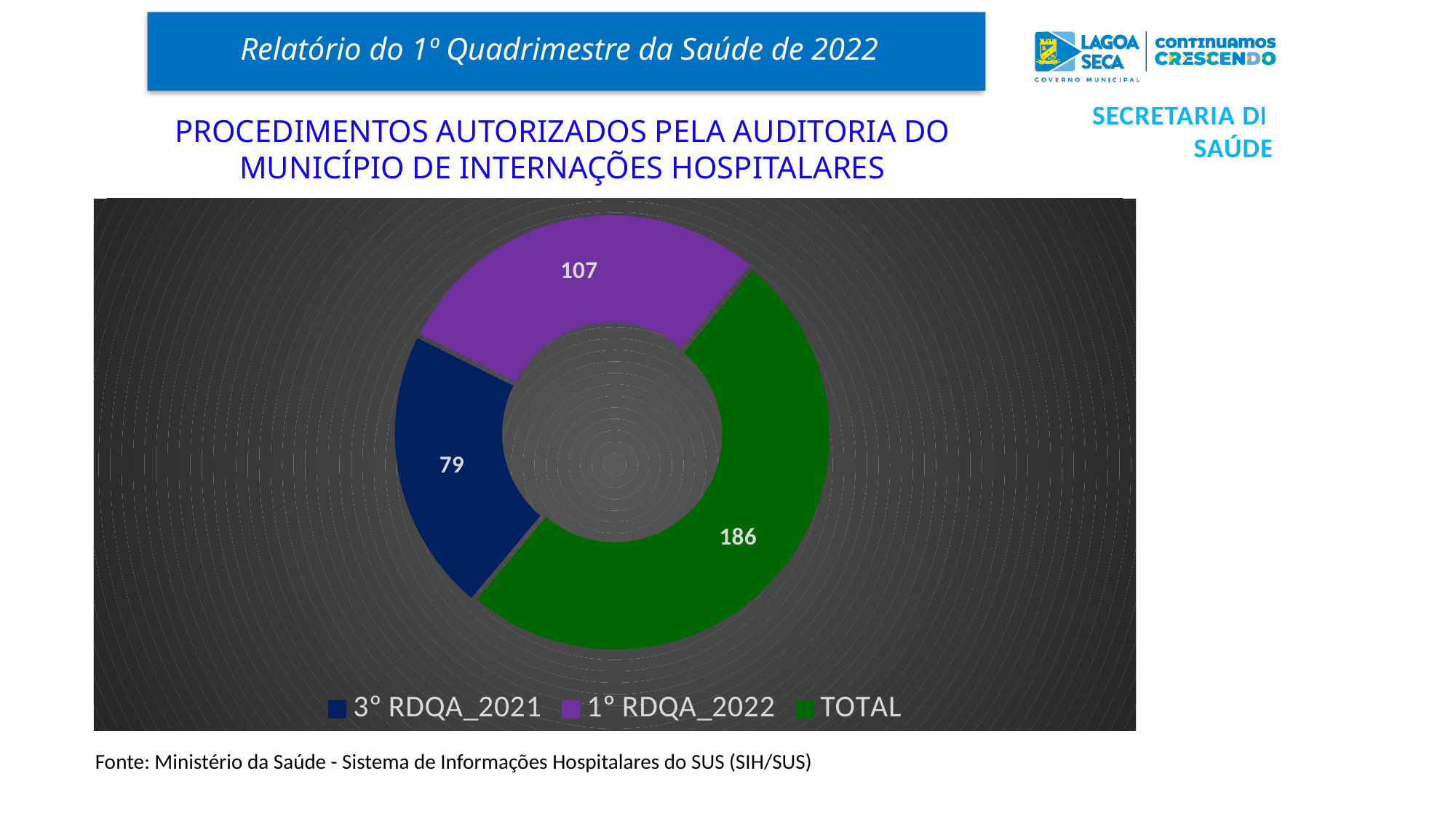
What colour is the slice for 1° RDQA_2022? purple Which category has the smallest slice? 3° RDQA_2021 Which is larger, the value for 1° RDQA_2022 or the value for 3° RDQA_2021? 1° RDQA_2022 What share of the whole doughnut does the TOTAL slice represent? 50% What is the value for TOTAL? 186 What is the difference between the values for 1° RDQA_2022 and 3° RDQA_2021? 28 How many entries does the legend list? 3 What is the value for 1° RDQA_2022? 107 How many slices does the chart have? 3 Which category has the largest slice? TOTAL What type of chart is shown on the slide? doughnut chart What is the value for 3° RDQA_2021? 79